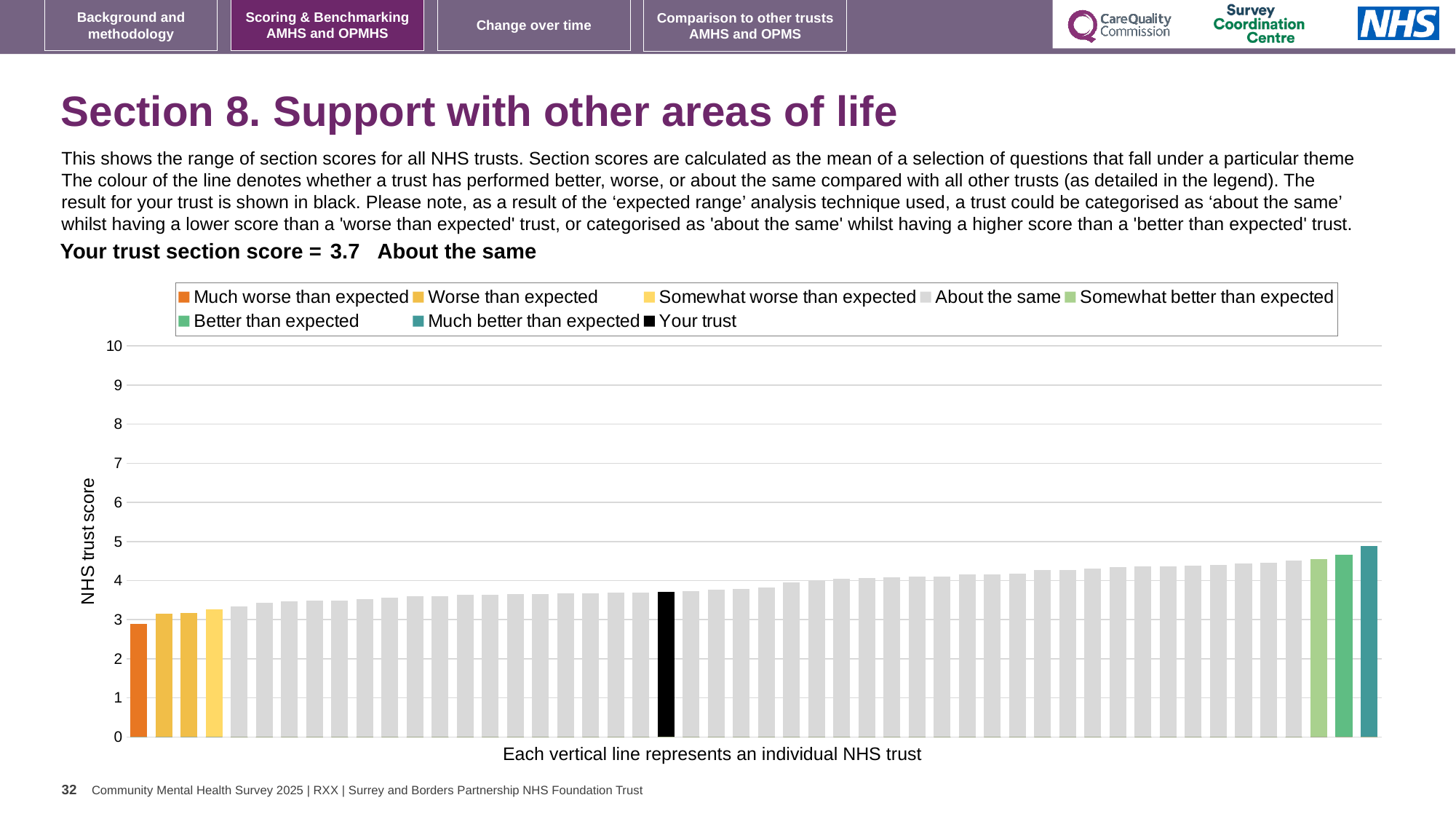
What kind of chart is shown on the slide? bar chart What is the title of the vertical axis? NHS trust score Is the value of the black 'Your trust' bar greater or less than 3? greater Is the value of the rightmost (teal) bar greater or less than 4? greater Which category is your trust placed in for this section? About the same Which legend category does the lowest bar on the chart belong to? Much worse than expected Do the bar values rise or fall from left to right along the x axis? rise Which legend category does the highest bar on the chart belong to? Much better than expected What is the section score for your trust? 3.7 Is the value of the black 'Your trust' bar greater or less than 4? less How many entries does the chart legend list? 8